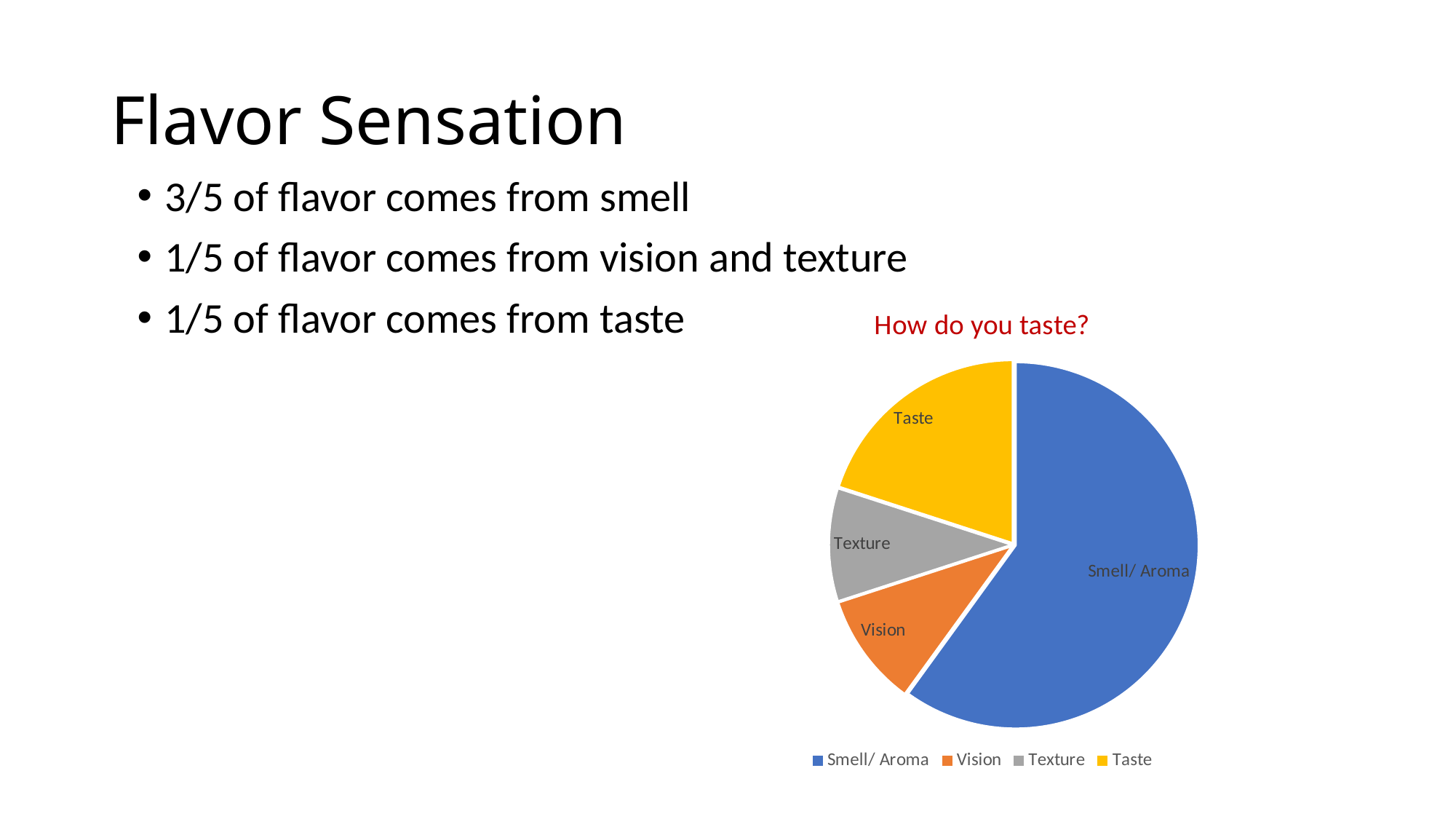
Which slice of the pie chart is the largest? Smell/ Aroma What is the title of the pie chart? How do you taste? How many entries does the legend of the pie chart list? 4 Which slice is larger in the pie chart, Texture or Taste? Taste What colour is the Taste slice in the pie chart? Yellow Which slice is larger in the pie chart, Smell/ Aroma or Taste? Smell/ Aroma How many slices does the pie chart have? 4 What kind of chart is shown on the slide? Pie chart Which slice is larger in the pie chart, Smell/ Aroma or Vision? Smell/ Aroma